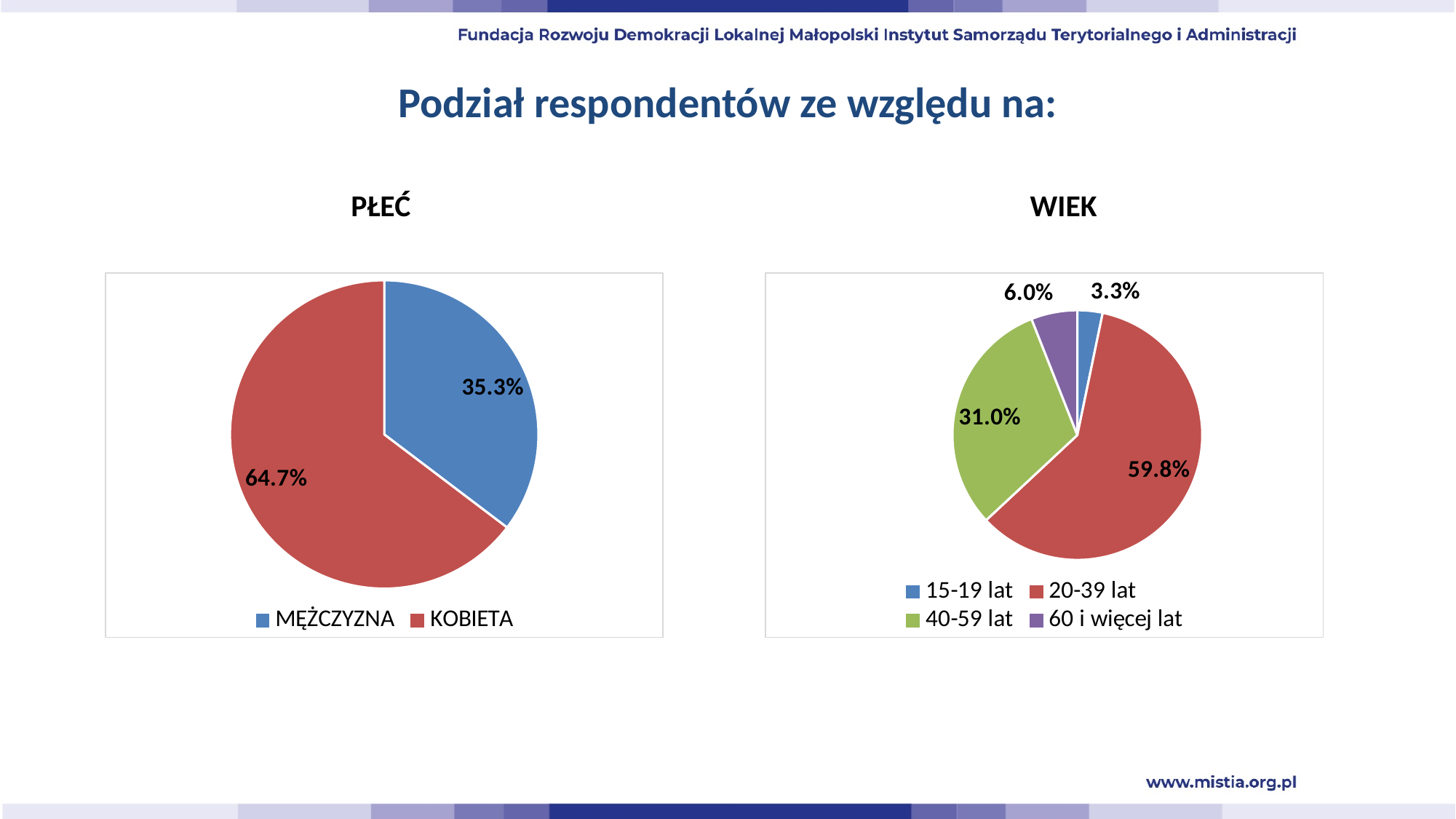
In the WIEK chart, which age group has the smallest share? 15-19 lat In the WIEK chart, what share of respondents are 60 i więcej lat? 6.0% In the PŁEĆ chart, which category has the larger share? KOBIETA In the WIEK chart, what share of respondents are 40-59 lat? 31.0% What kind of chart is the PŁEĆ chart? Pie chart In the WIEK chart, which age group has the largest share? 20-39 lat How many categories does the WIEK chart show? 4 In the WIEK chart, what colour is the slice for 40-59 lat? Green In the PŁEĆ chart, what share of respondents are KOBIETA? 64.7% In the PŁEĆ chart, what is the difference in percentage points between KOBIETA and MĘŻCZYZNA? 29.4 In the PŁEĆ chart, what share of respondents are MĘŻCZYZNA? 35.3% In the WIEK chart, what share of respondents are 20-39 lat? 59.8%